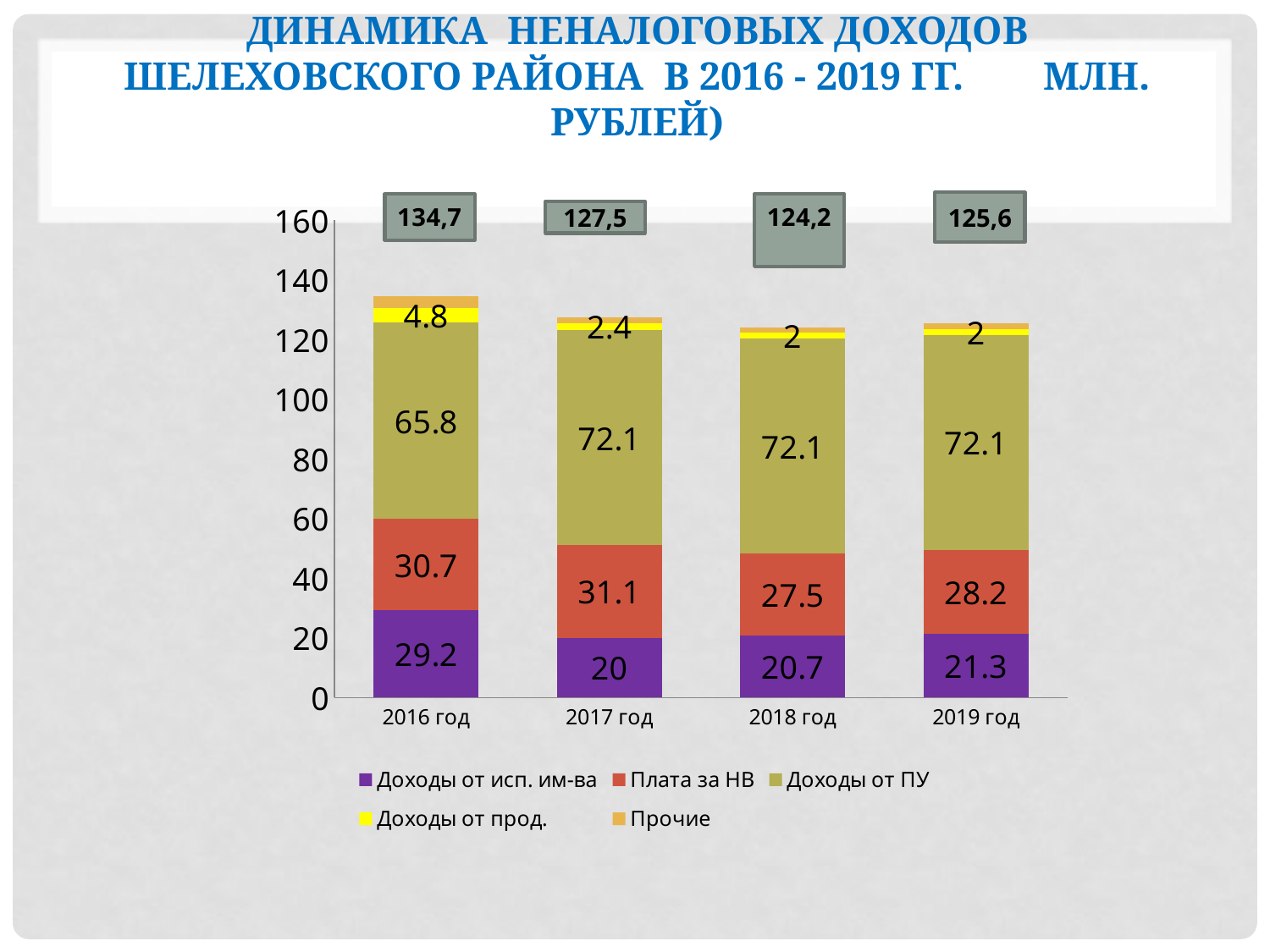
How many series does the legend list? 5 What is the difference between Доходы от ПУ in 2017 год and in 2016 год? 6.3 What kind of chart is shown on the slide? Stacked bar chart What is the value of Доходы от прод. for 2016 год? 4.8 Which year has the lowest total shown above its bar? 2018 год How many years are shown on the x axis? 4 What is the total for the 2019 год bar as printed above it? 125,6 Which is larger: Плата за НВ in 2017 год or in 2019 год? 2017 год What is the value of Доходы от ПУ for 2017 год? 72.1 What is the value of Доходы от исп. им-ва for 2016 год? 29.2 Which year has the highest total shown above its bar? 2016 год What is the value of Плата за НВ for 2018 год? 27.5